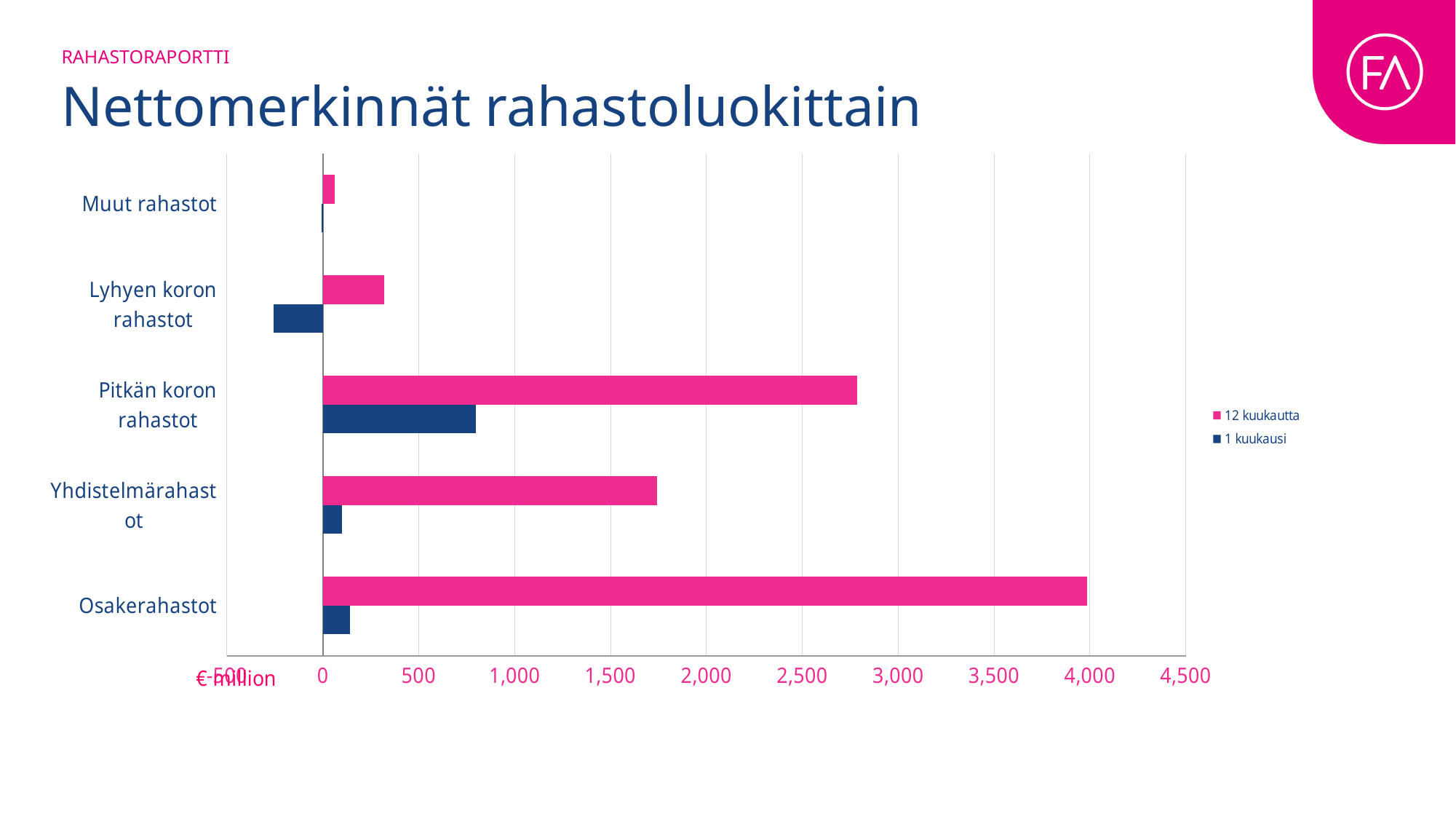
Is the 1 kuukausi value for Lyhyen koron rahastot greater or less than 0? less Which category has the highest value for the 1 kuukausi series? Pitkän koron rahastot What kind of chart is shown on the slide? bar chart Which category has the lowest value for the 1 kuukausi series? Lyhyen koron rahastot Is the 12 kuukautta value for Pitkän koron rahastot greater or less than 3,000? less Which is larger: the 12 kuukautta value for Yhdistelmärahastot or the 12 kuukautta value for Pitkän koron rahastot? Pitkän koron rahastot Which category has the lowest value for the 12 kuukautta series? Muut rahastot Which category has the highest value for the 12 kuukautta series? Osakerahastot What is the title of the chart on the slide? Nettomerkinnät rahastoluokittain Is the 12 kuukautta value for Osakerahastot greater or less than 3,500? greater How many series does the legend list? 2 How many fund categories are shown on the chart? 5